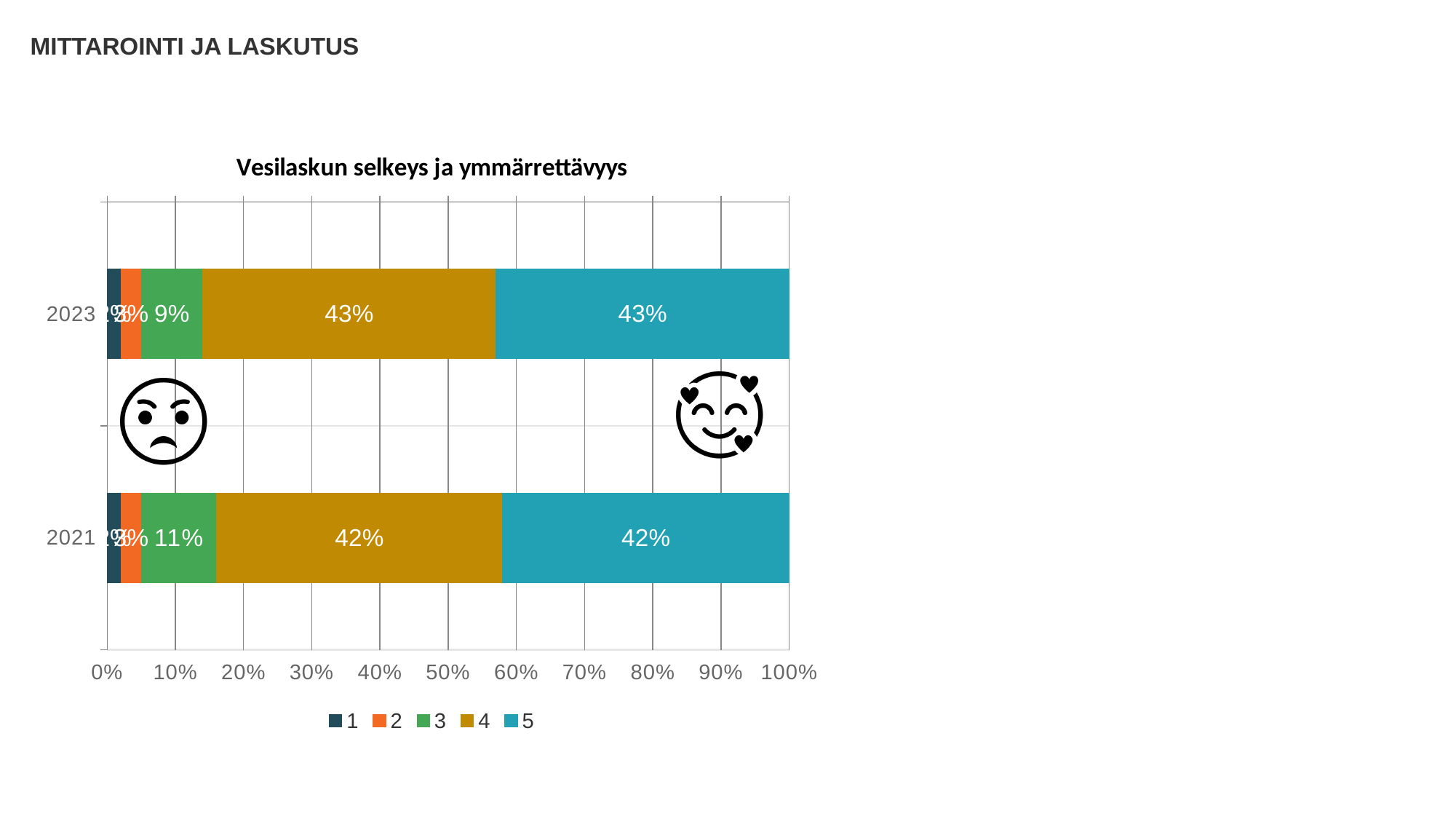
What is the value for series 5 in 2021? 42% How many categories (years) are shown on the chart? 2 What kind of chart is shown on the slide? bar chart What is the title of the chart? Vesilaskun selkeys ja ymmärrettävyys What is the difference between the series 3 values for 2021 and 2023? 2% What is the value for series 3 in 2023? 9% What is the value for series 4 in 2023? 43% Which year has the larger value for series 3, 2021 or 2023? 2021 Which colour represents series 5 in the legend? teal What is the value for series 3 in 2021? 11% What is the difference between the series 4 values for 2023 and 2021? 1% How many series does the legend list? 5